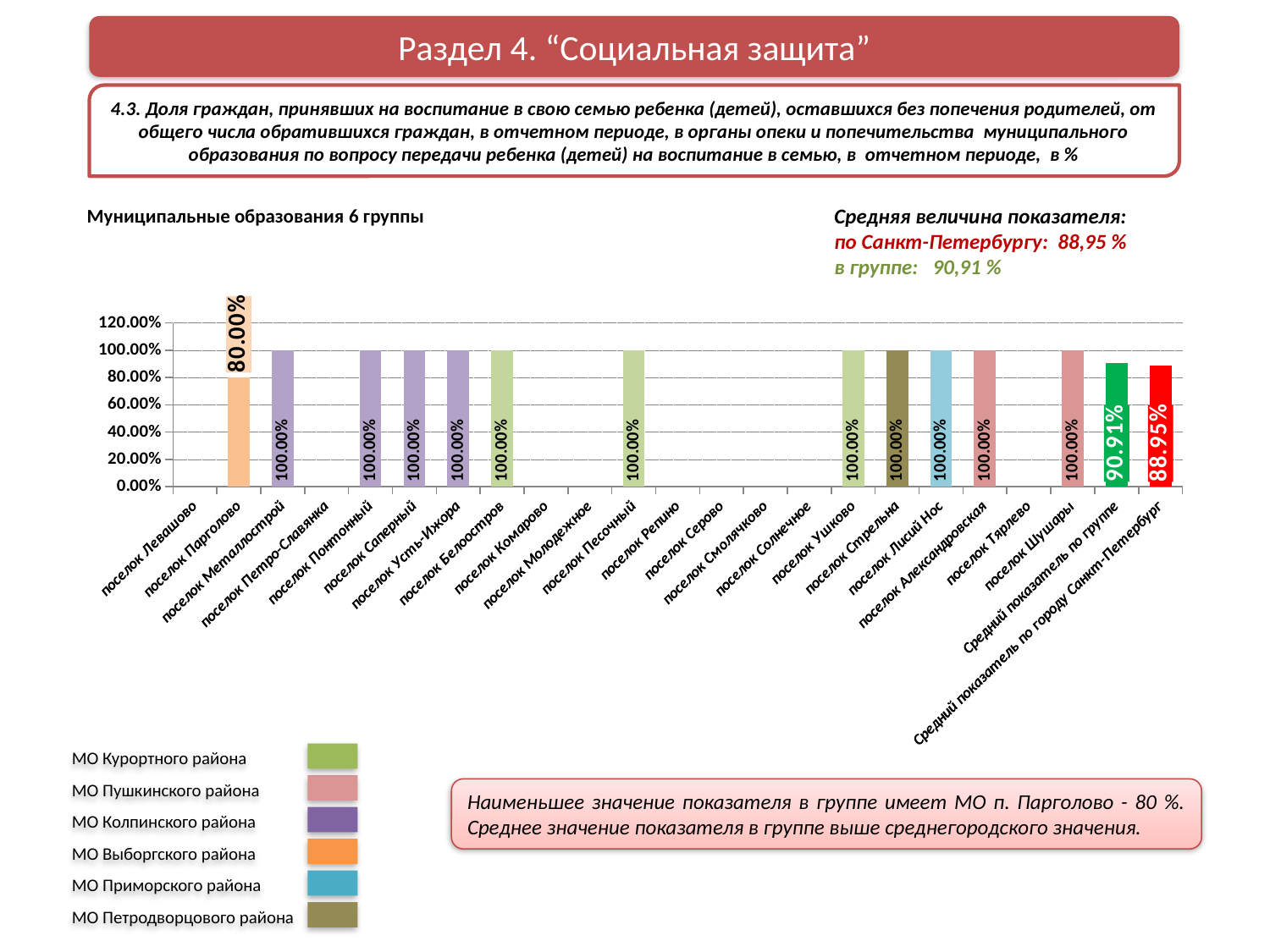
Which category has the lowest value among the bars shown? поселок Парголово What is the value for Средний показатель по группе? 90.91% How many entries does the legend at the bottom of the slide list? 6 Is the value for Средний показатель по группе greater or less than 100.00%? less What kind of chart is shown on the slide? bar chart What is the value for поселок Стрельна? 100.00% What is the difference between the value for поселок Металлострой and the value for поселок Парголово? 20.00% What is the difference between the value for Средний показатель по группе and the value for Средний показатель по городу Санкт-Петербург? 1.96% What is the value for Средний показатель по городу Санкт-Петербург? 88.95% How many categories are listed on the x axis? 23 What is the value for поселок Парголово? 80.00% Which is larger, the value for поселок Парголово or the value for поселок Шушары? поселок Шушары